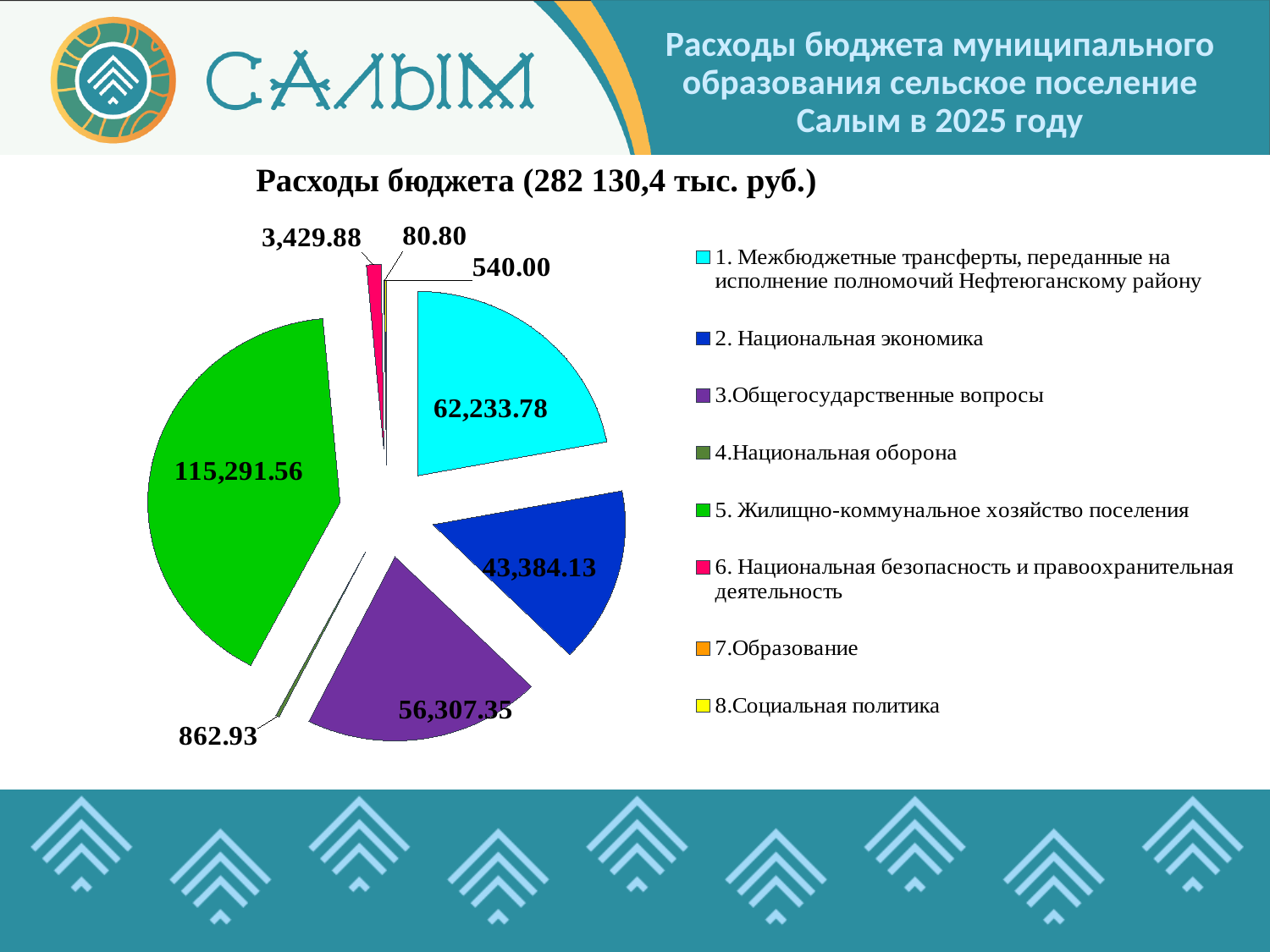
What is the value for "4.Национальная оборона"? 862.93 What kind of chart is shown on the slide? pie chart What is the title of the chart? Расходы бюджета (282 130,4 тыс. руб.) What is the value for "6. Национальная безопасность и правоохранительная деятельность"? 3,429.88 What is the value for "1. Межбюджетные трансферты, переданные на исполнение полномочий Нефтеюганскому району"? 62,233.78 How many categories does the legend of the pie chart list? 8 Which is larger: the value for "3.Общегосударственные вопросы" or the value for "2. Национальная экономика"? 3.Общегосударственные вопросы What is the value for "5. Жилищно-коммунальное хозяйство поселения"? 115,291.56 Which category has the largest slice of the pie? 5. Жилищно-коммунальное хозяйство поселения What is the value for "2. Национальная экономика"? 43,384.13 What is the difference between the value for "5. Жилищно-коммунальное хозяйство поселения" and the value for "1. Межбюджетные трансферты, переданные на исполнение полномочий Нефтеюганскому району"? 53,057.78 What is the value for "3.Общегосударственные вопросы"? 56,307.35